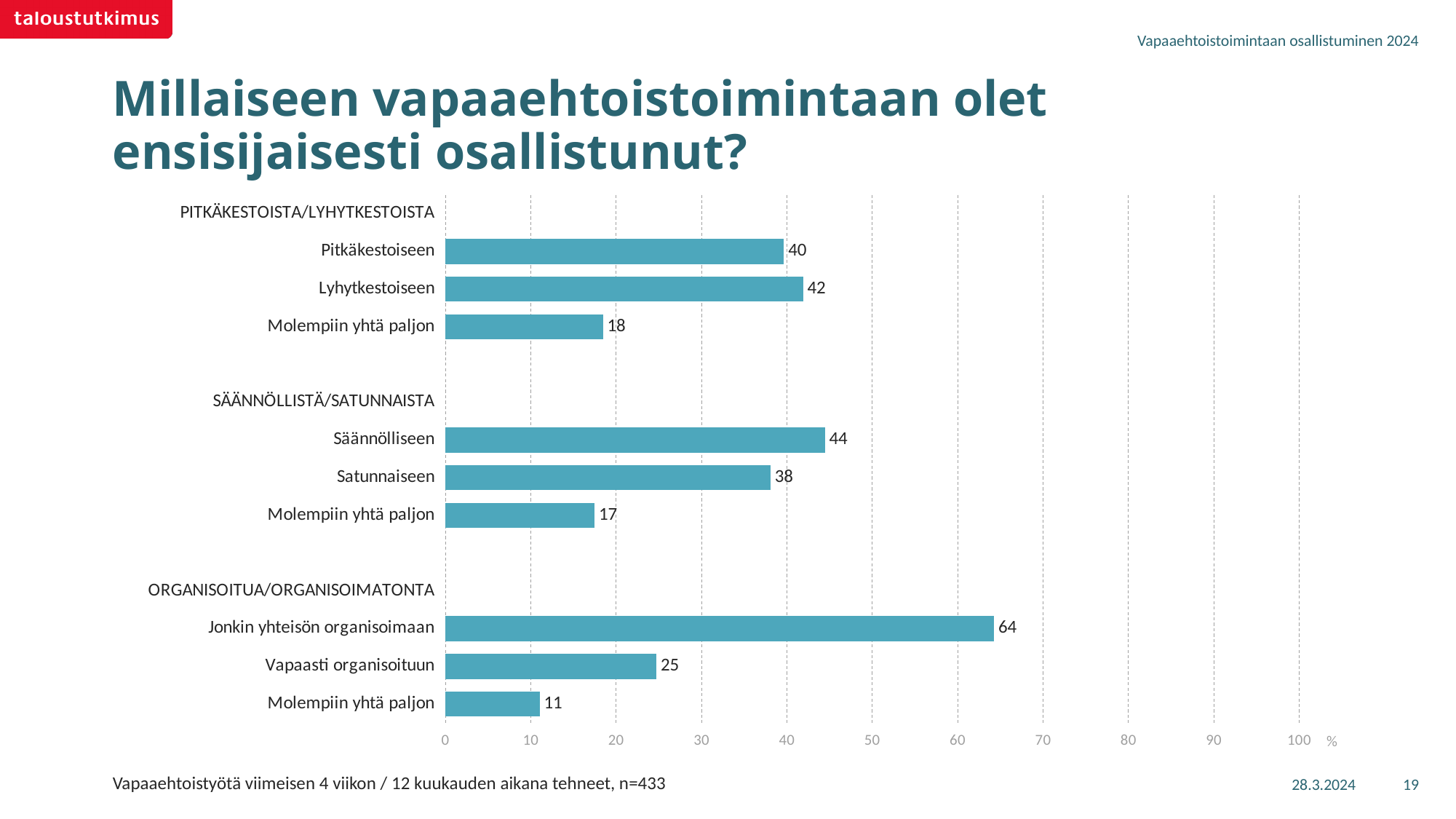
What is the difference between Säännölliseen and Satunnaiseen? 6 What is the value for Jonkin yhteisön organisoimaan? 64 What unit is shown at the end of the x axis? % What is the value for Pitkäkestoiseen? 40 How many bars are plotted in the chart? 9 Which category has the lowest value in the chart? Molempiin yhtä paljon (ORGANISOITUA/ORGANISOIMATONTA) What kind of chart is shown on the slide? bar chart Which category has the highest value in the chart? Jonkin yhteisön organisoimaan What is the difference between Jonkin yhteisön organisoimaan and Vapaasti organisoituun? 39 What is the value for Molempiin yhtä paljon in the SÄÄNNÖLLISTÄ/SATUNNAISTA group? 17 Which is larger, Pitkäkestoiseen or Lyhytkestoiseen? Lyhytkestoiseen Is the value for Vapaasti organisoituun greater or less than 30? less